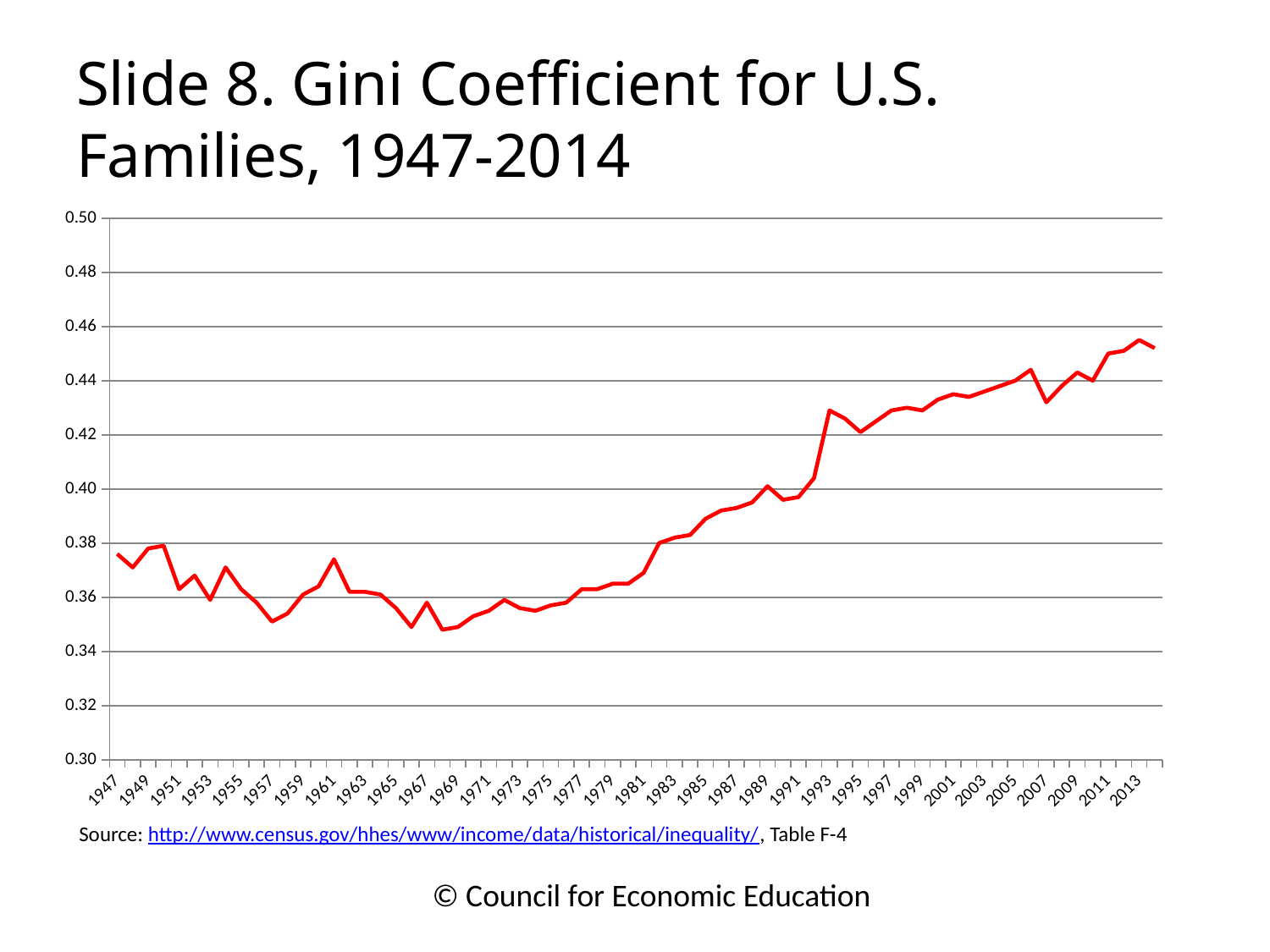
Overall, does the Gini coefficient rise or fall from 1947 to 2014? rise Is the Gini coefficient for 1975 greater or less than 0.38? less Which year has the larger Gini coefficient, 1947 or 1969? 1947 Is the Gini coefficient for 1947 greater or less than 0.36? greater What colour is the plotted line in the chart? red Is the Gini coefficient for 1993 greater or less than 0.42? greater What kind of chart is shown on the slide? line chart Which year has the larger Gini coefficient, 1983 or 1993? 1993 How many data series (lines) are plotted in the chart? 1 What is the title of the chart on the slide? Slide 8. Gini Coefficient for U.S. Families, 1947-2014